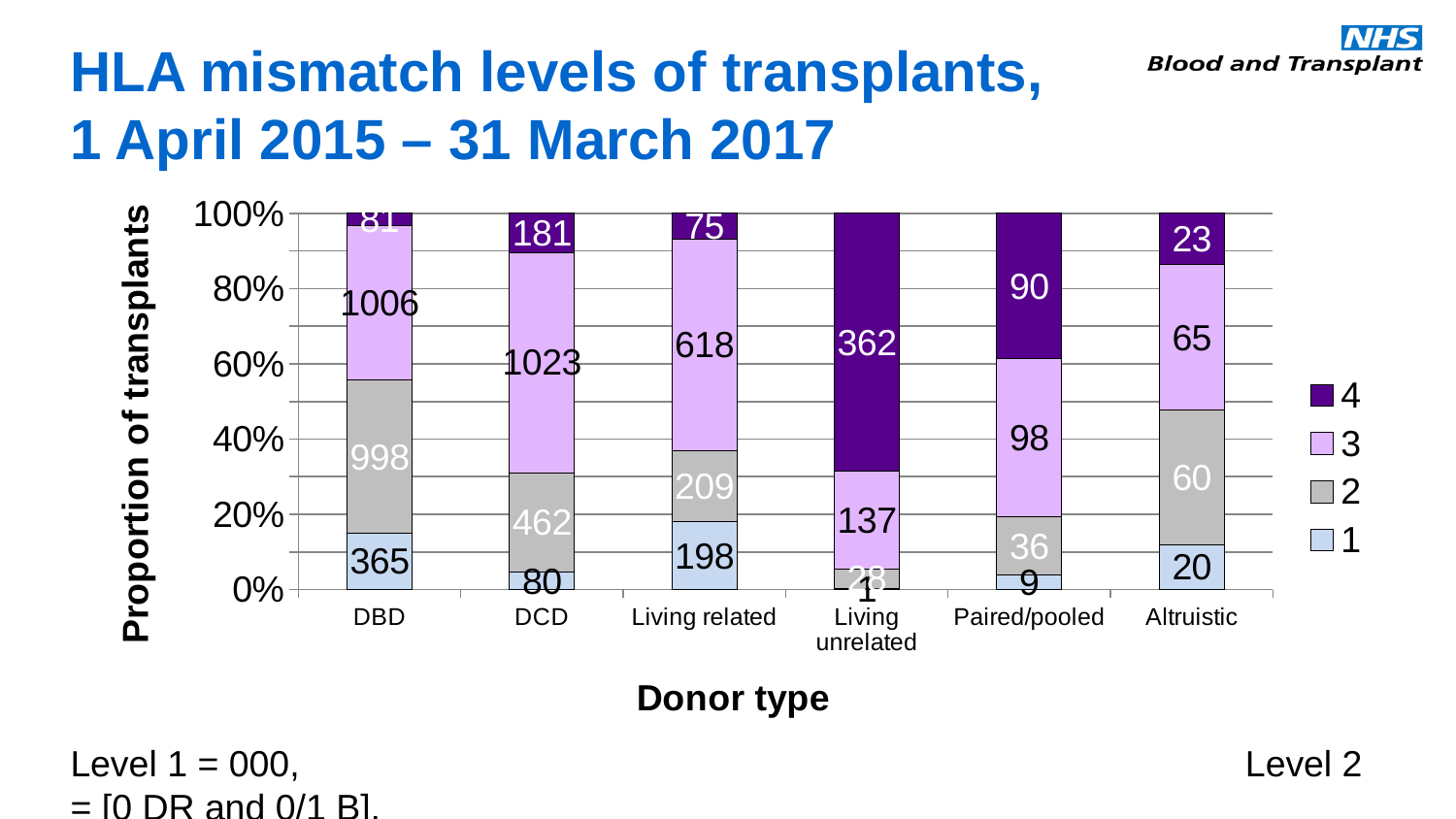
Which is larger, the level 4 value for DCD or the level 4 value for Living related? DCD How many series does the legend list? 4 What is the value for level 3 in the DCD bar? 1023 How many donor types are shown on the x axis? 6 What is the value for level 4 in the Living unrelated bar? 362 What is the value for level 2 in the Altruistic bar? 60 What is the total number of transplants in the Paired/pooled bar? 233 What is the value for level 1 in the Living related bar? 198 What is the difference between the level 3 and level 2 values in the DBD bar? 8 What is the label of the y axis? Proportion of transplants What kind of chart is shown on the slide? Stacked bar chart What is the total number of transplants in the Altruistic bar? 168